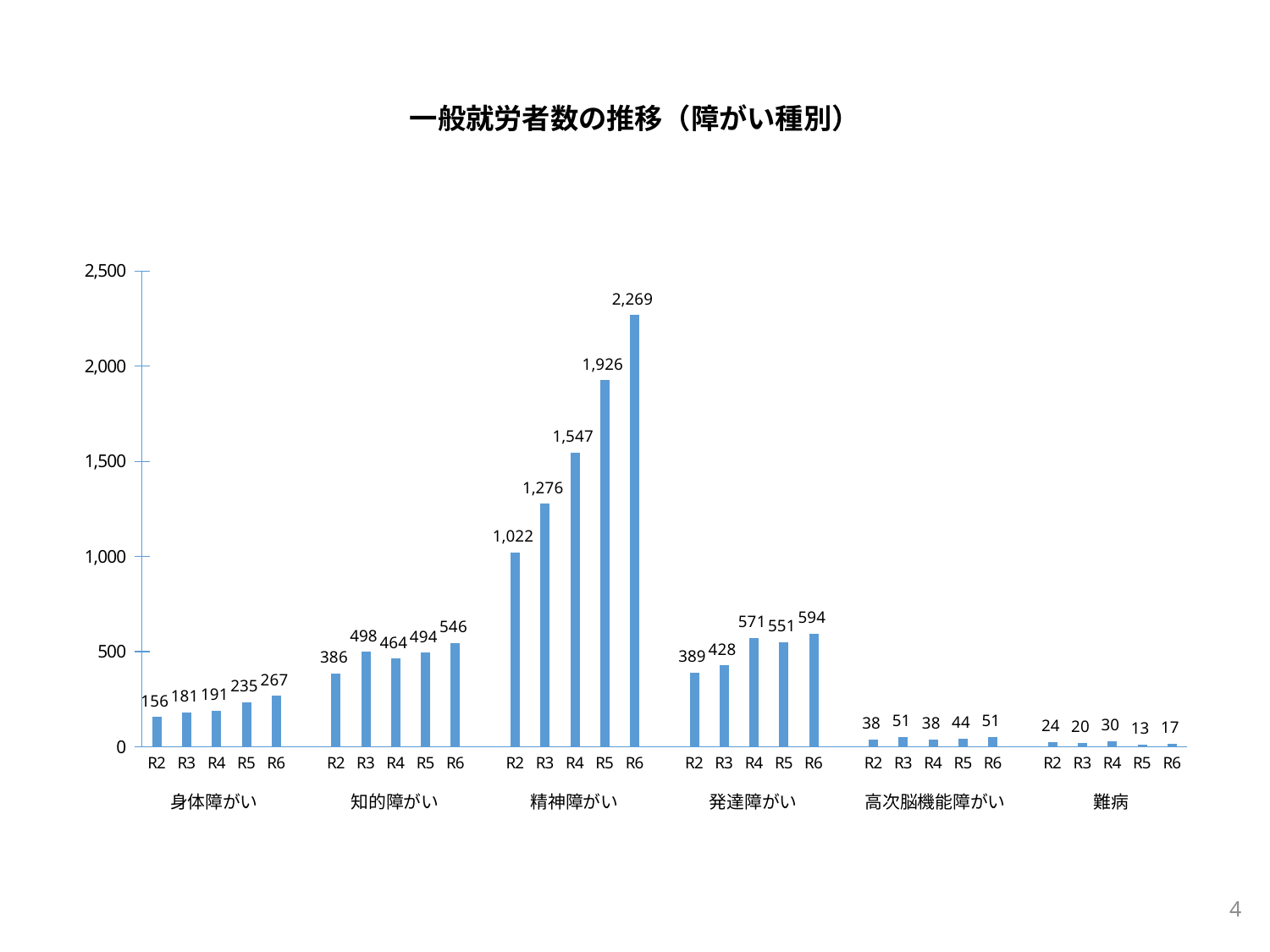
What is the difference between the R6 and R5 values for 知的障がい? 52 Do the values for 精神障がい rise or fall from R2 to R6? rise How many disability groups are shown on the x axis? 6 What kind of chart is shown on the slide? bar chart Which disability group has the highest bar on the chart? 精神障がい Which is larger, the R4 value for 発達障がい or the R6 value for 知的障がい? R4 value for 発達障がい What is the difference between the R6 and R2 values for 精神障がい? 1,247 What is the value for 難病 in R5? 13 What is the value for 精神障がい in R6? 2,269 Is the R5 value for 精神障がい greater or less than 2,000? less What is the value for 身体障がい in R2? 156 Which year has the lowest value within the 難病 group? R5